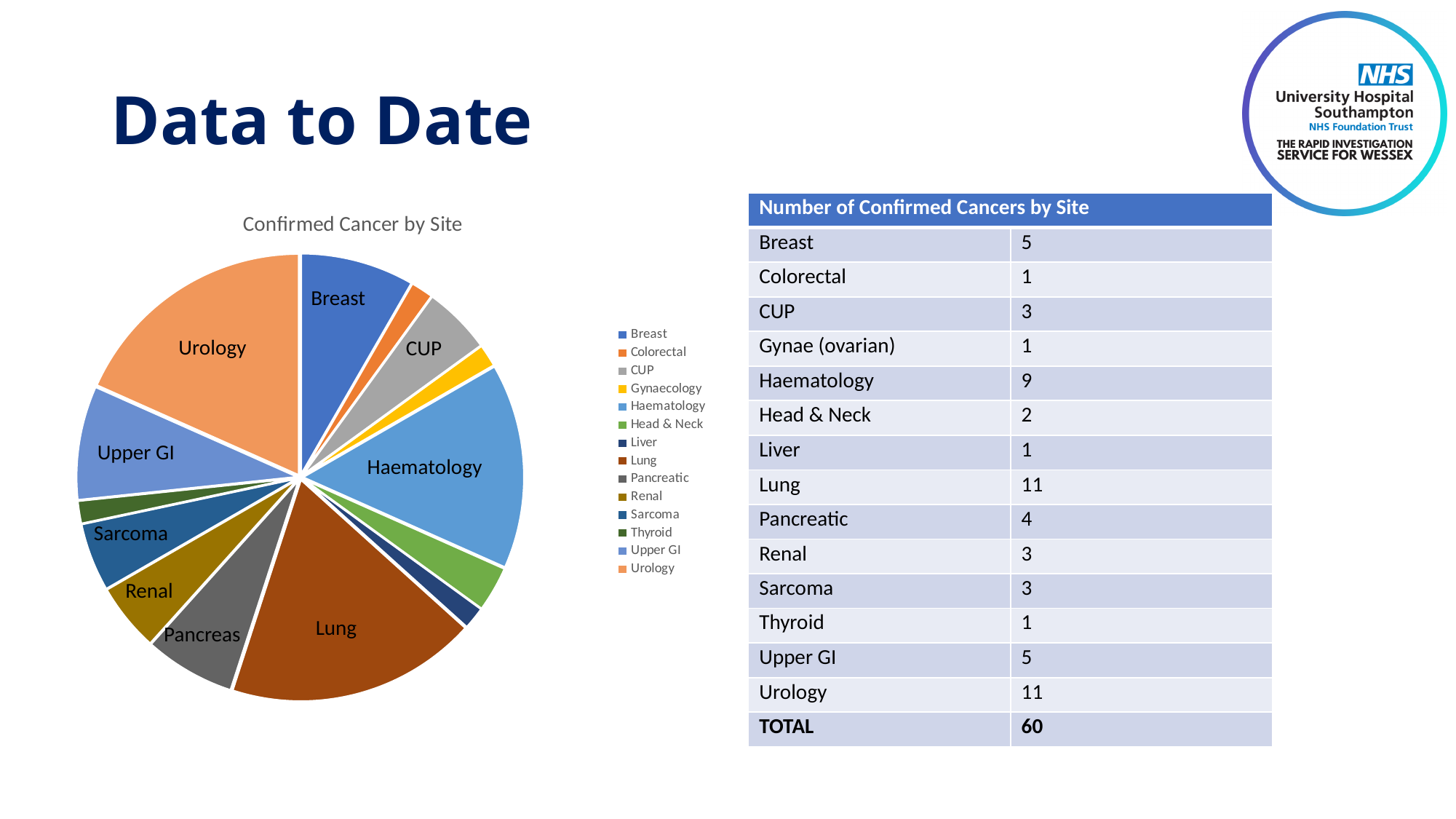
What is the difference between the number of confirmed Lung cancers and confirmed Breast cancers in the table? 6 According to the table, how many confirmed cancers are there for Pancreatic? 4 According to the table, how many confirmed cancers are there for Haematology? 9 According to the table, how many confirmed cancers are there for Upper GI? 5 How many categories does the 'Confirmed Cancer by Site' pie chart show? 14 What is the title of the pie chart on the slide? Confirmed Cancer by Site What kind of chart is the 'Confirmed Cancer by Site' chart? pie chart In the 'Confirmed Cancer by Site' pie chart, which slice is larger, Lung or Pancreas? Lung In the 'Confirmed Cancer by Site' pie chart, which slice is larger, Haematology or Breast? Haematology What is the total number of confirmed cancers shown in the table? 60 According to the table, how many confirmed cancers are there for Lung? 11 How many entries does the legend of the 'Confirmed Cancer by Site' pie chart list? 14